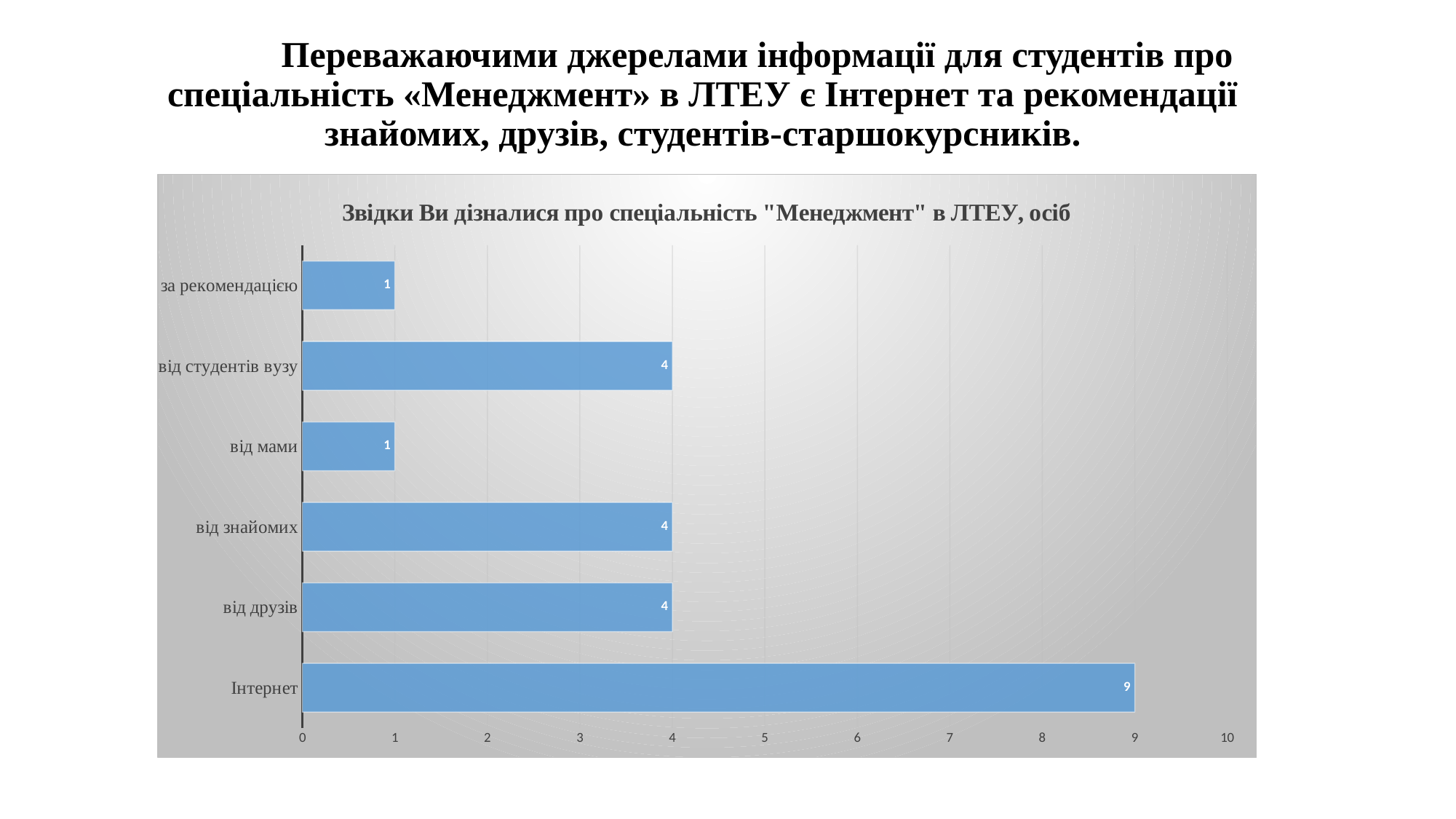
What is the value for від друзів? 4 What is the difference between the values for Інтернет and від знайомих? 5 What is the value for від студентів вузу? 4 Which is larger, the value for від студентів вузу or the value for за рекомендацією? від студентів вузу Is the value for Інтернет greater or less than 5? greater What is the maximum value shown on the horizontal axis? 10 How many categories are shown in the chart? 6 What kind of chart is shown on the slide? bar chart What is the title of the chart? Звідки Ви дізналися про спеціальність "Менеджмент" в ЛТЕУ, осіб Which category has the highest value? Інтернет What is the value for від мами? 1 What is the value for Інтернет? 9